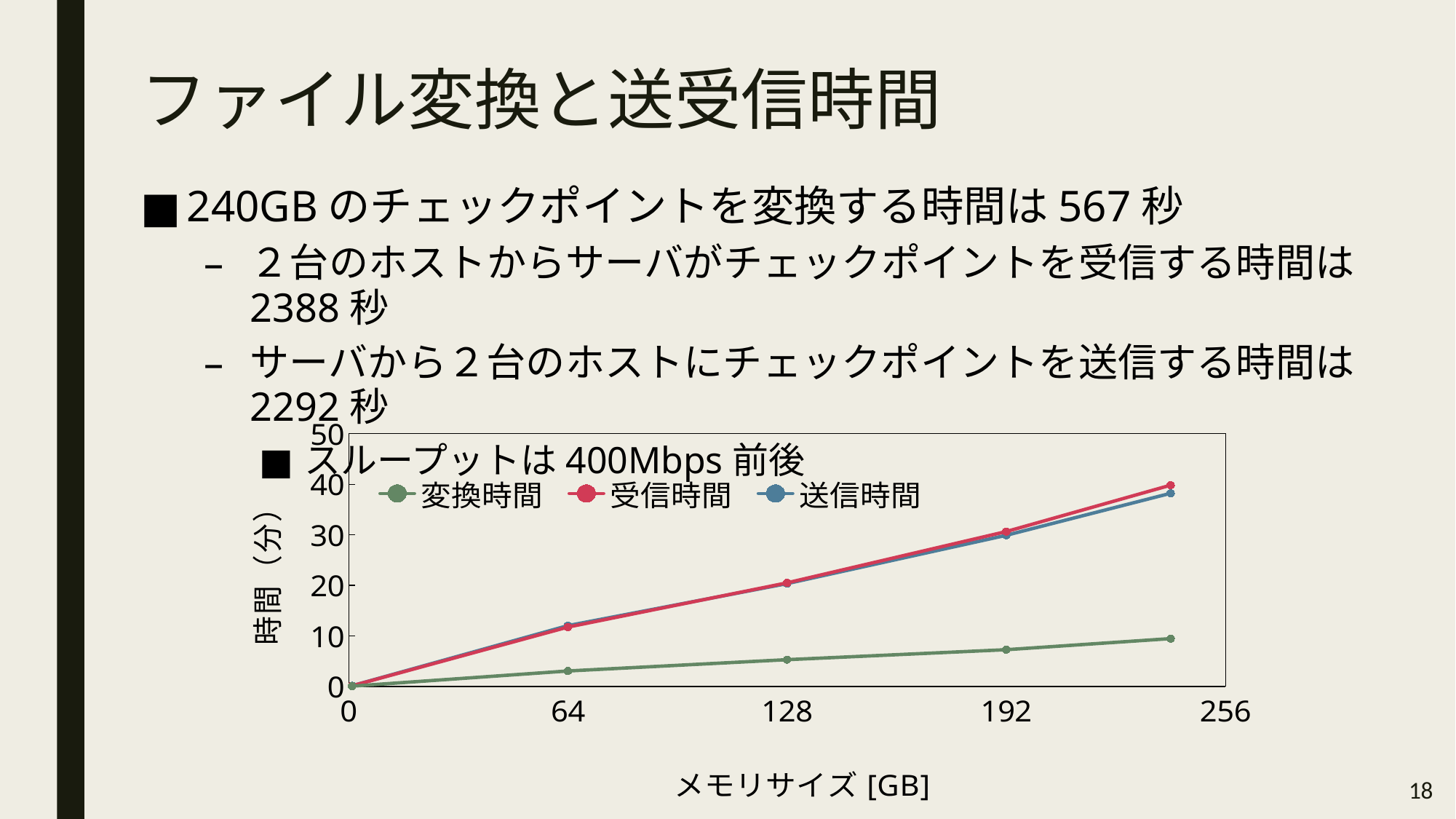
How many data points are plotted for the 変換時間 series? 5 What are the three series named in the chart legend? 変換時間, 受信時間, 送信時間 What is the x-axis title of the chart? メモリサイズ [GB] How many series does the chart legend list? 3 At the largest memory size, which series has the larger value: 受信時間 or 変換時間? 受信時間 Is the value of 送信時間 at the largest memory size greater or less than 30? greater What kind of chart is shown on the slide? line chart Which series has the lowest value at 192 GB? 変換時間 Does the 変換時間 series rise or fall as memory size increases along the x axis? rise Does the 受信時間 series rise or fall as memory size increases along the x axis? rise Is the value of 受信時間 at 64 GB greater or less than 10? greater